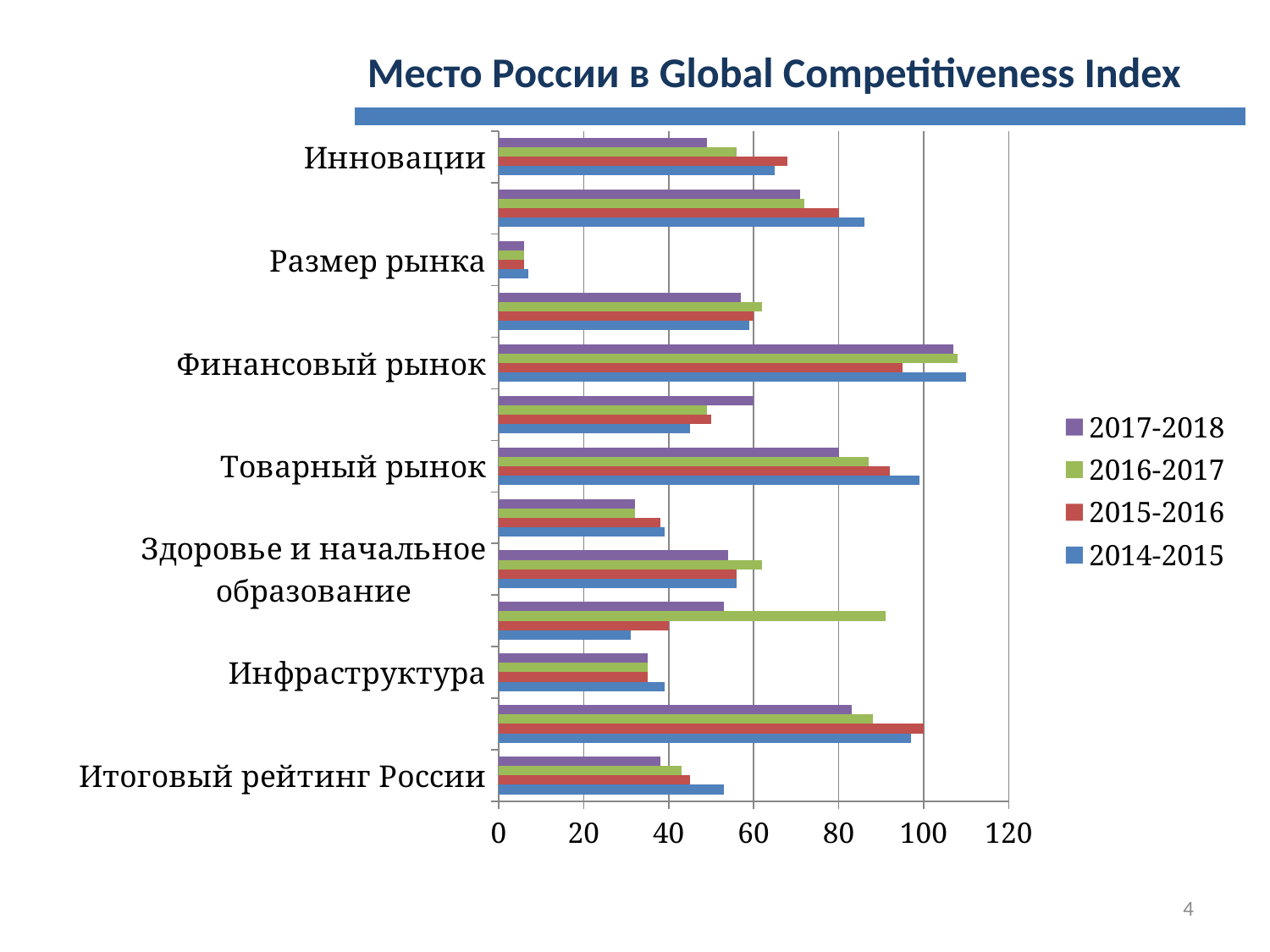
For Итоговый рейтинг России, which is larger: the 2014-2015 value or the 2017-2018 value? 2014-2015 Is the 2015-2016 value for Инновации greater or less than 60? greater What kind of chart is shown on the slide? bar chart For Товарный рынок, which series has the highest value? 2014-2015 Which category has the lowest 2014-2015 value? Размер рынка Which series are listed in the legend? 2017-2018, 2016-2017, 2015-2016, 2014-2015 Is the 2014-2015 value for Финансовый рынок greater or less than 100? greater What is the title of the chart? Место России в Global Competitiveness Index For Товарный рынок, which series has the lowest value? 2017-2018 Is the 2017-2018 value for Размер рынка greater or less than 20? less How many series does the legend list? 4